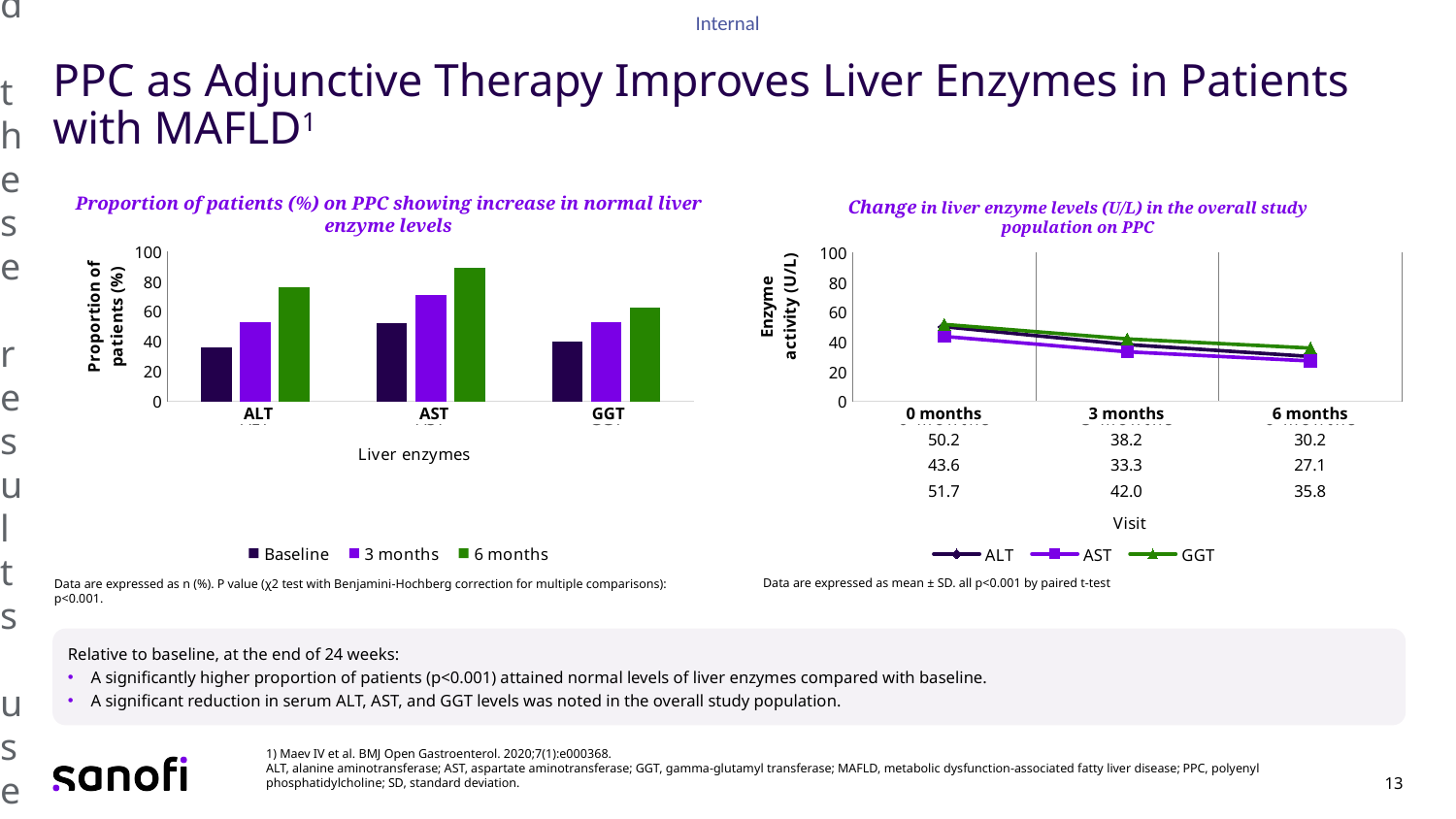
In the right chart, what is the difference between the AST value at 0 months and at 6 months? 16.5 In the left chart, how many series does the legend list? 3 In the right chart, what is the GGT value at 6 months? 35.8 In the right chart, what is the ALT value at 0 months? 50.2 In the left chart, how many liver enzyme categories are shown on the x axis? 3 What kind of chart is the left chart, 'Proportion of patients (%) on PPC showing increase in normal liver enzyme levels'? bar chart In the left chart, for GGT, which is larger: the Baseline bar or the 6 months bar? 6 months In the left chart, is the 6 months value for AST greater or less than 80? greater In the left chart, which liver enzyme has the highest 6 months bar? AST In the right chart, do the enzyme levels rise or fall from 0 months to 6 months? fall What kind of chart is the right chart, 'Change in liver enzyme levels (U/L) in the overall study population on PPC'? line chart In the left chart, is the Baseline value for ALT greater or less than 40? less